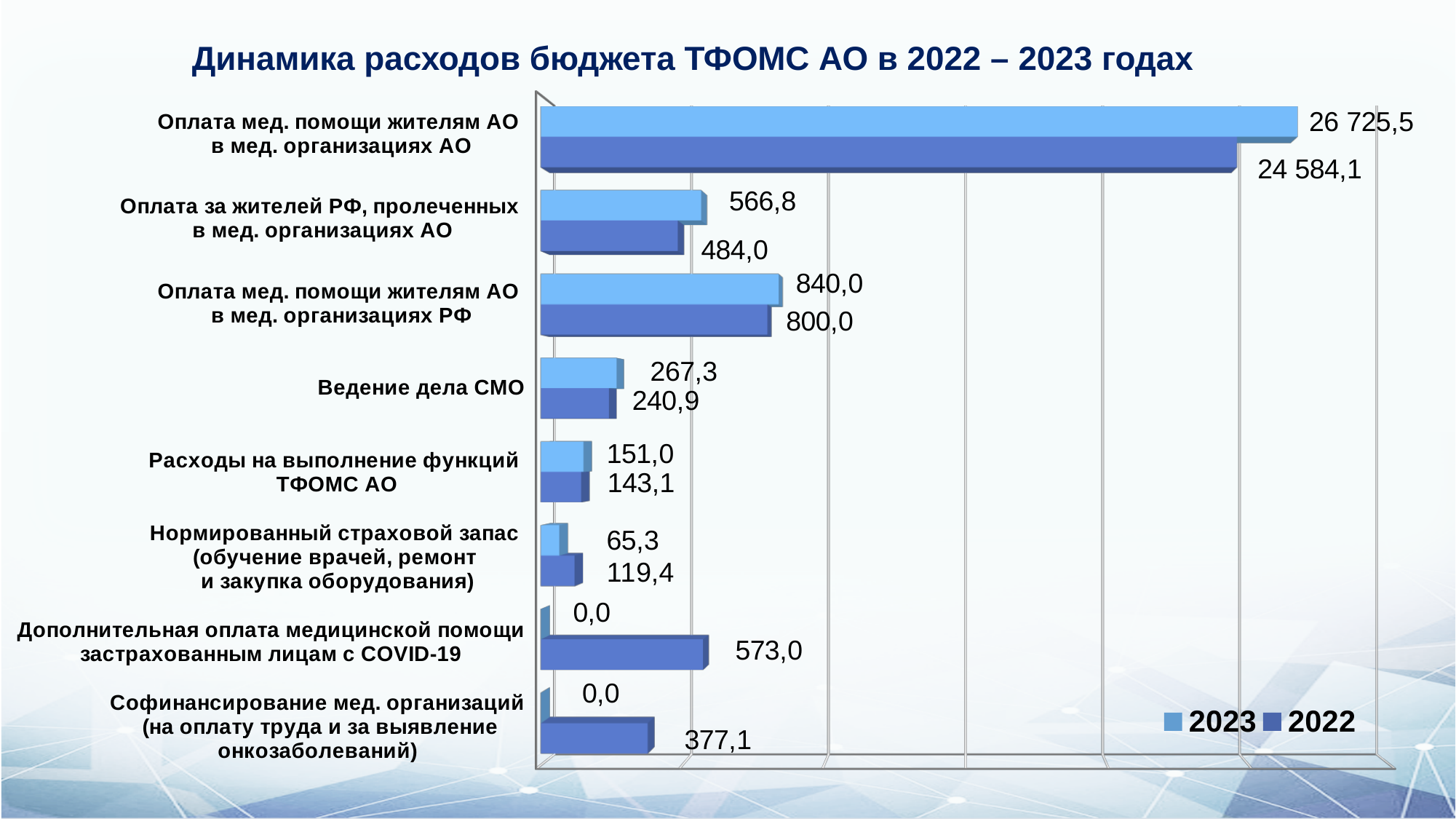
What is the difference between the 2022 and 2023 values for "Нормированный страховой запас (обучение врачей, ремонт и закупка оборудования)"? 54,1 What is the 2022 value for "Ведение дела СМО"? 240,9 How many series does the legend list? 2 What is the 2023 value for "Оплата мед. помощи жителям АО в мед. организациях АО"? 26 725,5 For "Оплата за жителей РФ, пролеченных в мед. организациях АО", which year has the larger value, 2023 or 2022? 2023 Which category has the highest 2022 value? Оплата мед. помощи жителям АО в мед. организациях АО How many categories are shown on the chart? 8 What type of chart is shown on the slide? Bar chart What is the 2023 value for "Нормированный страховой запас (обучение врачей, ремонт и закупка оборудования)"? 65,3 What is the difference between the 2023 and 2022 values for "Оплата мед. помощи жителям АО в мед. организациях РФ"? 40,0 What is the title of the chart? Динамика расходов бюджета ТФОМС АО в 2022 – 2023 годах What is the 2022 value for "Дополнительная оплата медицинской помощи застрахованным лицам с COVID-19"? 573,0